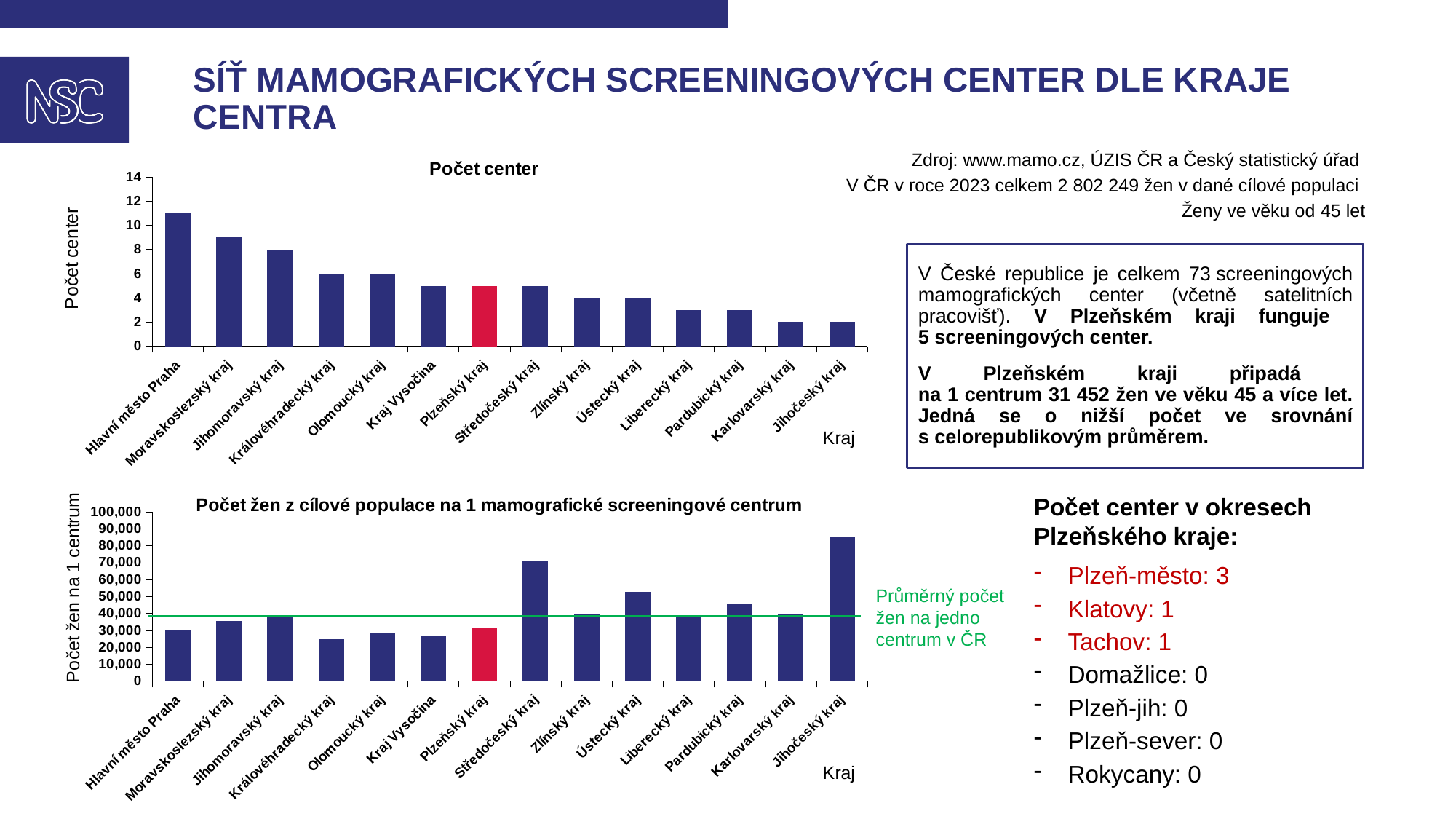
In the bottom chart, what does the green horizontal line represent? Průměrný počet žen na jedno centrum v ČR In the bottom chart 'Počet žen z cílové populace na 1 mamografické screeningové centrum', is the value for Královéhradecký kraj greater or less than 30,000? less In the top chart 'Počet center', what is the value for Královéhradecký kraj? 6 In the bottom chart 'Počet žen z cílové populace na 1 mamografické screeningové centrum', is the value for Středočeský kraj greater or less than 60,000? greater In the top chart 'Počet center', how many centres does Plzeňský kraj have? 5 What kind of chart is the bottom chart 'Počet žen z cílové populace na 1 mamografické screeningové centrum'? bar chart In the top chart 'Počet center', which is larger: the value for Moravskoslezský kraj or the value for Zlínský kraj? Moravskoslezský kraj In the top chart 'Počet center', what is the value for Jihomoravský kraj? 8 In the bottom chart 'Počet žen z cílové populace na 1 mamografické screeningové centrum', which region has the highest value? Jihočeský kraj In the bottom chart 'Počet žen z cílové populace na 1 mamografické screeningové centrum', which is larger: the value for Ústecký kraj or the value for Olomoucký kraj? Ústecký kraj In the top chart 'Počet center', which region has the highest number of centres? Hlavní město Praha In the top chart 'Počet center', how many regions (categories) are shown on the x axis? 14